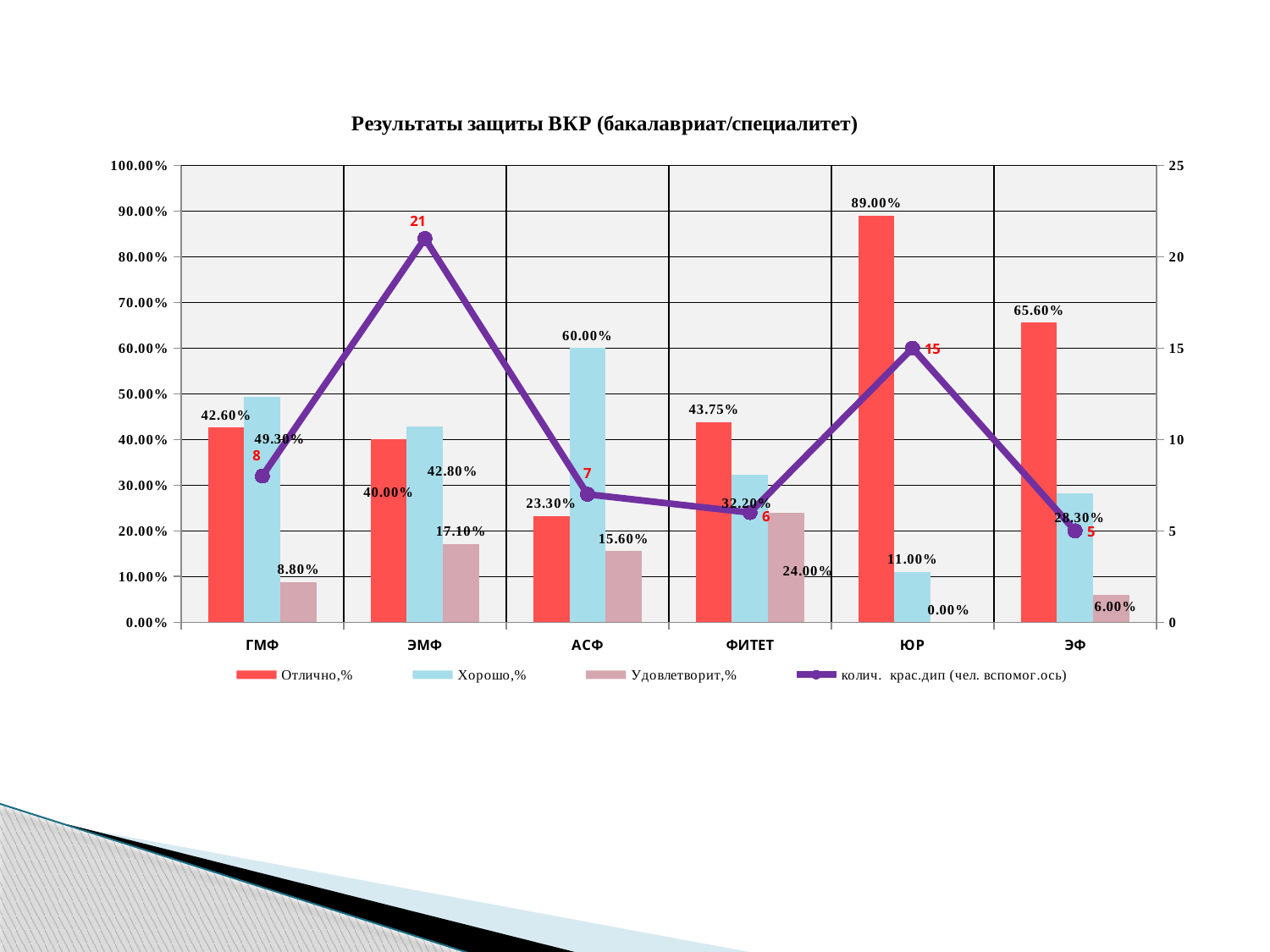
What is the value of Отлично,% for ЮР? 89.00% What is the difference between the Отлично,% values for ЮР and ЭФ? 23.40% Which category has the lowest value of колич. крас.дип? ЭФ What is the title of the chart? Результаты защиты ВКР (бакалавриат/специалитет) How many faculty categories are shown on the x axis? 6 What is the value of Удовлетворит,% for ФИТЕТ? 24.00% How many series does the legend list? 4 Which category has the lowest value of Отлично,%? АСФ What is the value of колич. крас.дип for ЭМФ? 21 Which is larger, the Хорошо,% value for АСФ or for ЭМФ? АСФ What kind of chart is shown on the slide? Combined bar and line chart Which category has the highest value of Отлично,%? ЮР